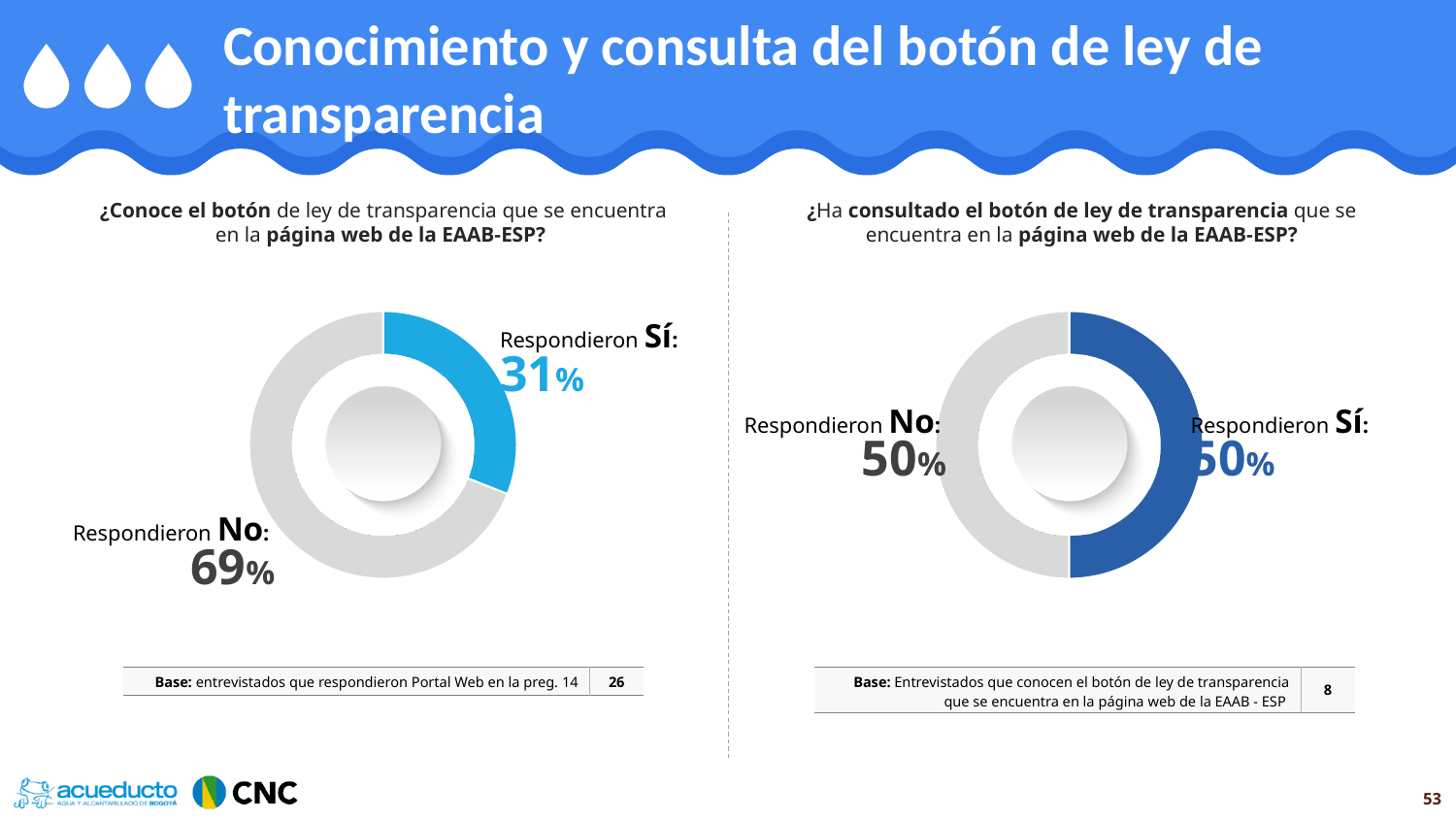
In the left chart, is the share of respondents who answered Sí greater or less than 50%? less In the right chart, what is the difference in percentage points between the Sí and No responses? 0 In the left chart, which response has the larger share, Sí or No? No What type of chart is used on the left side of the slide? Donut (pie) chart In the left chart (¿Conoce el botón de ley de transparencia...?), what percentage of respondents answered No? 69% In the right chart (¿Ha consultado el botón de ley de transparencia...?), what percentage of respondents answered No? 50% What is the base (number of respondents) for the right chart? 8 In the left chart (¿Conoce el botón de ley de transparencia...?), what percentage of respondents answered Sí? 31% How many response categories are shown in the right chart? 2 What is the base (number of respondents) for the left chart? 26 In the right chart (¿Ha consultado el botón de ley de transparencia...?), what percentage of respondents answered Sí? 50% In the left chart, what is the difference in percentage points between the No and Sí responses? 38